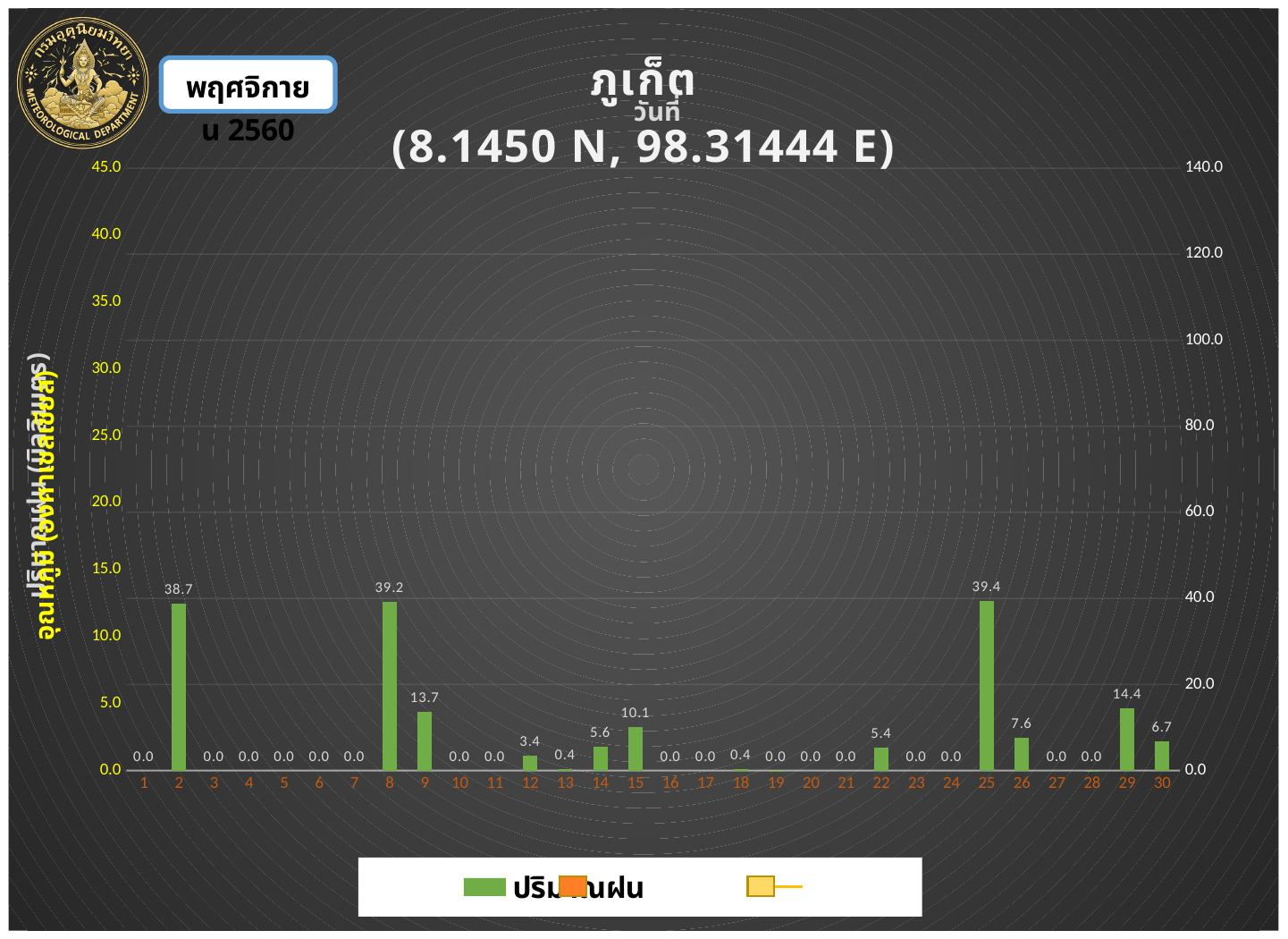
What is the difference between the rainfall values for day 25 and day 8? 0.2 What is the rainfall value shown for day 15? 10.1 What kind of chart is used to show the rainfall data? bar chart What is the rainfall value shown for day 25? 39.4 Which day has the highest rainfall value according to the data labels? 25 How many days are shown on the x axis of the chart? 30 What coordinates are given in the chart title? 8.1450 N, 98.31444 E What is the difference between the rainfall values for day 29 and day 9? 0.7 What is the rainfall value shown for day 29? 14.4 What is the rainfall value shown for day 2? 38.7 Which day has the larger rainfall value, day 26 or day 30? 26 What is the rainfall value shown for day 9? 13.7